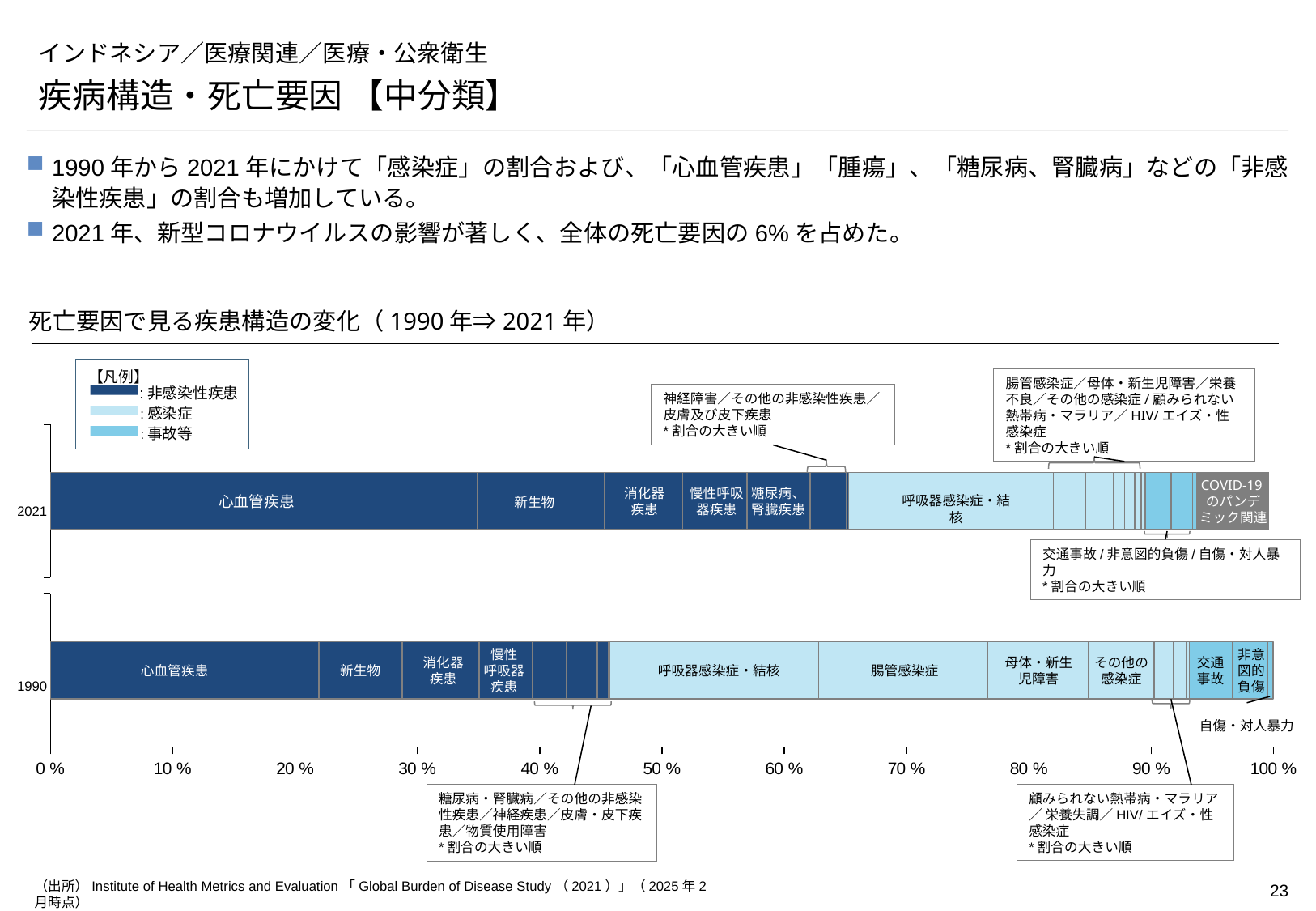
Is the share of 心血管疾患 in 2021 greater or less than 30%? greater Which year has the larger share of 腸管感染症, 1990 or 2021? 1990 Is the share of 心血管疾患 in 1990 greater or less than 30%? less How many categories does the legend (凡例) list? 3 Is the share of 新生物 in 1990 greater or less than 10%? less Which segment is the largest in the 2021 bar? 心血管疾患 Which segment is the largest in the 1990 bar? 心血管疾患 Which year has the larger share of 心血管疾患, 1990 or 2021? 2021 What kind of chart is shown on the slide? Stacked bar chart How many years (bars) are plotted in the chart? 2 What is the title of the chart? 死亡要因で見る疾患構造の変化（1990年⇒2021年） Which year's bar includes a segment for COVID-19のパンデミック関連? 2021